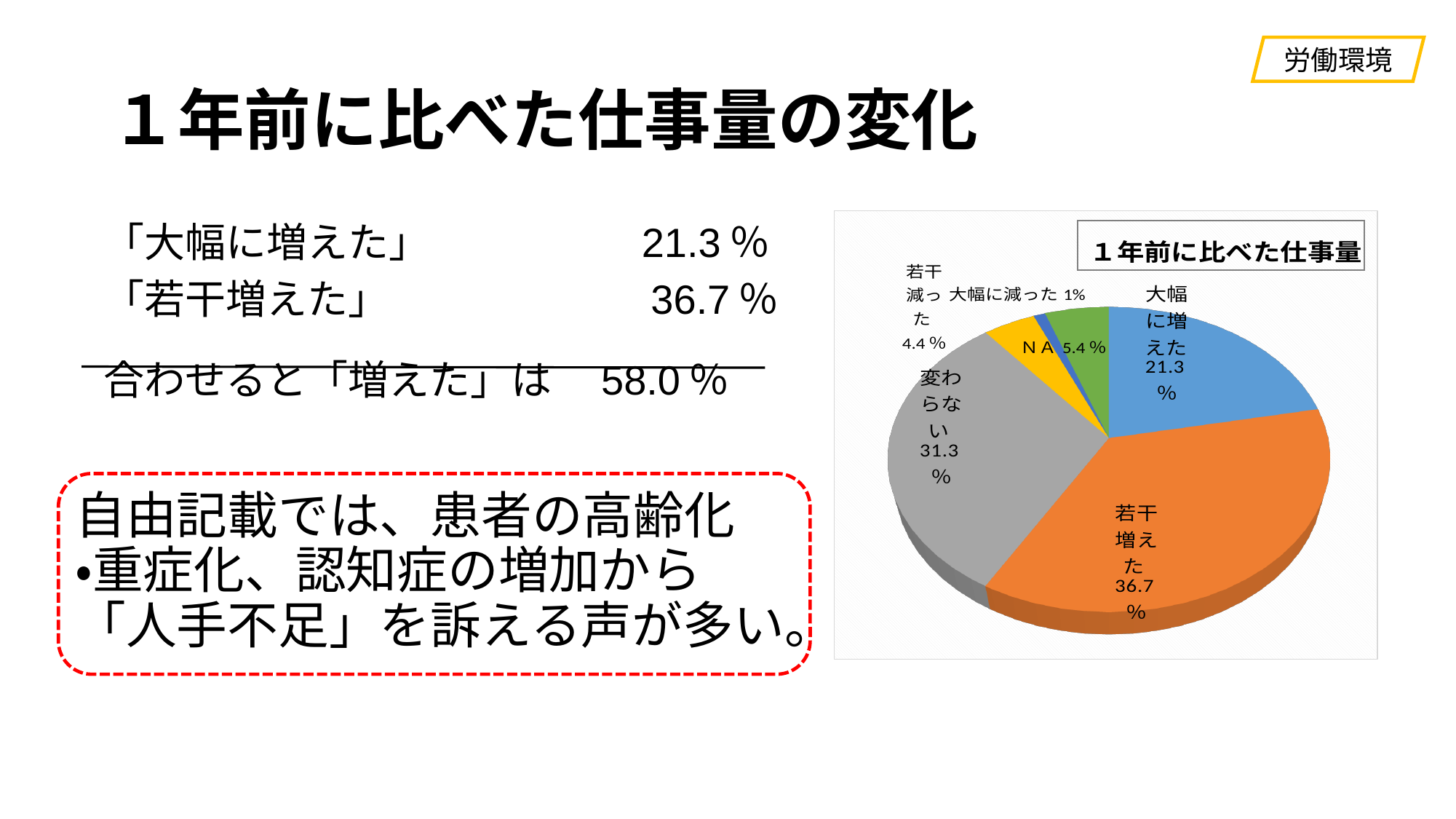
What percentage of the pie is labelled 「大幅に増えた」? 21.3％ What kind of chart is shown on the slide? Pie chart What percentage of the pie is labelled 「若干増えた」? 36.7％ Which is larger, the slice for 「変わらない」 or the slice for 「大幅に増えた」? 変わらない What is the difference in percentage points between 「若干増えた」 and 「大幅に増えた」? 15.4 What is the title of the chart? １年前に比べた仕事量 What percentage of the pie is labelled 「若干減った」? 4.4％ What percentage of the pie is labelled 「ＮＡ」? 5.4％ How many slices does the pie chart have? 6 What percentage of the pie is labelled 「変わらない」? 31.3％ Which slice of the pie is the largest? 若干増えた Which slice of the pie is the smallest? 大幅に減った